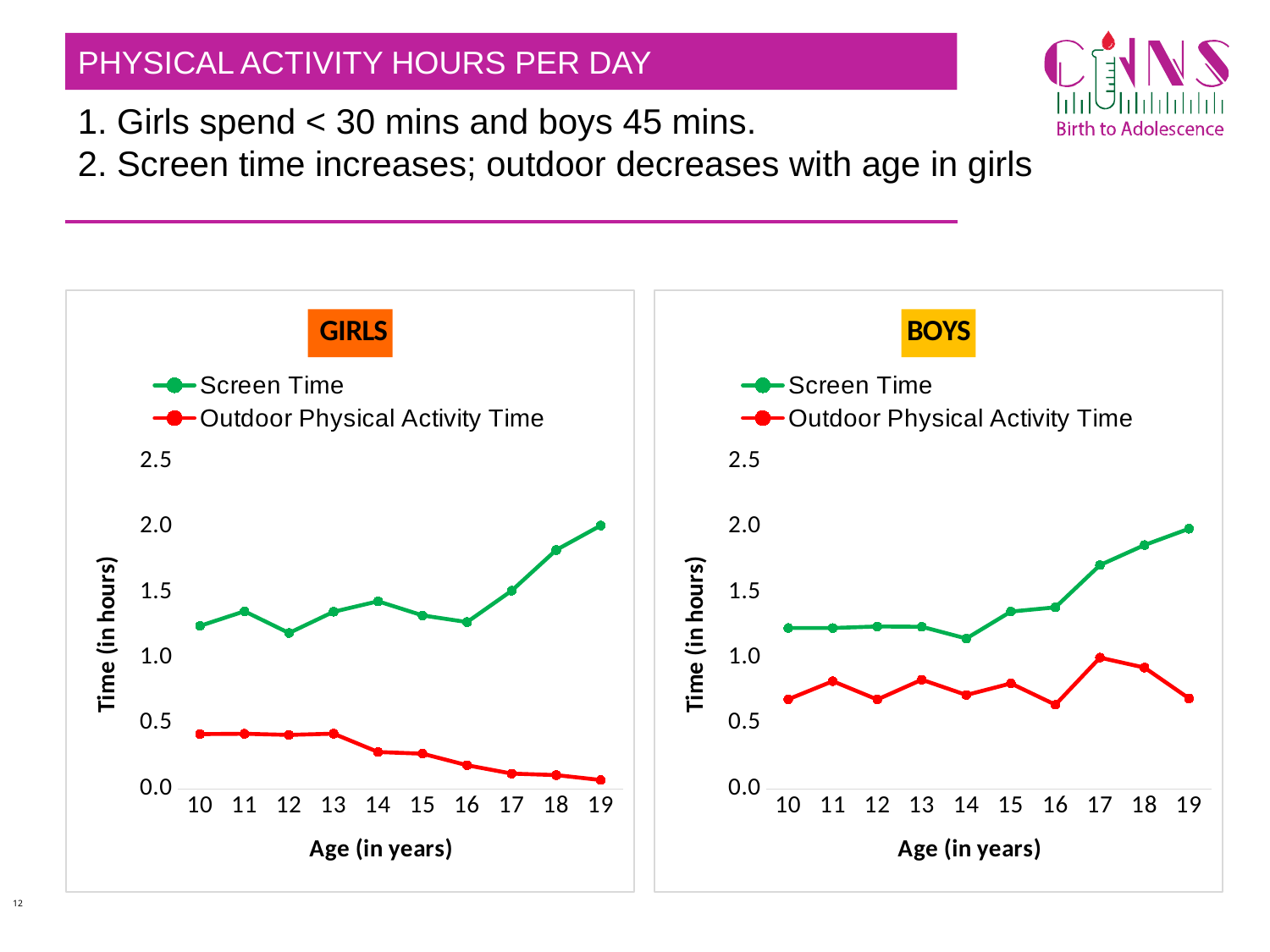
In the BOYS chart, which series has the larger value at age 10, Screen Time or Outdoor Physical Activity Time? Screen Time In the BOYS chart, is the Outdoor Physical Activity Time value at age 17 greater or less than 0.5? greater How many age points are plotted along the x axis of the GIRLS chart? 10 In the BOYS chart, does Screen Time rise or fall overall as age increases from 10 to 19? rise In the GIRLS chart, at which age is Screen Time highest? 19 In the GIRLS chart, at which age is Outdoor Physical Activity Time lowest? 19 How many series does the legend of the BOYS chart list? 2 In the GIRLS chart, is the Screen Time value at age 19 greater or less than 1.5? greater In the BOYS chart, at which age is Screen Time lowest? 14 In the BOYS chart, at which age is Outdoor Physical Activity Time highest? 17 In the GIRLS chart, does Outdoor Physical Activity Time rise or fall as age increases from 10 to 19? fall What kind of chart is the GIRLS chart? line chart